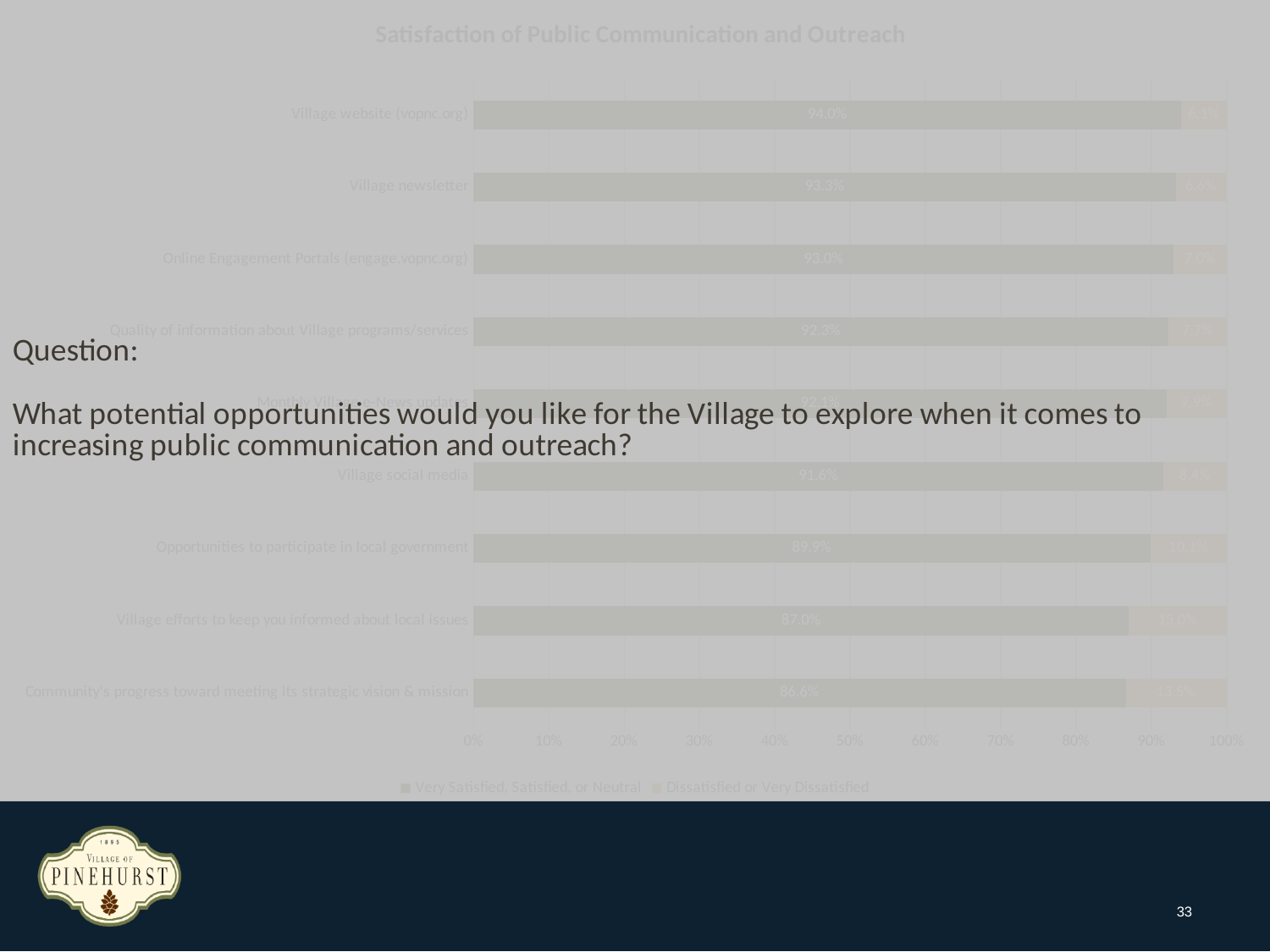
What is the difference between the Very Satisfied, Satisfied, or Neutral values for Village website (vopnc.org) and Village efforts to keep you informed about local issues? 7.0% What is the title of the chart? Satisfaction of Public Communication and Outreach How many series does the legend list? 2 Which category has the highest Very Satisfied, Satisfied, or Neutral value? Village website (vopnc.org) What kind of chart is shown on the slide? Bar chart What is the Very Satisfied, Satisfied, or Neutral value for Village newsletter? 93.3% What is the Very Satisfied, Satisfied, or Neutral value for Online Engagement Portals (engage.vopnc.org)? 93.0% Which category has the lowest Very Satisfied, Satisfied, or Neutral value? Community's progress toward meeting its strategic vision & mission What is the Very Satisfied, Satisfied, or Neutral value for Village website (vopnc.org)? 94.0% Which has a larger Very Satisfied, Satisfied, or Neutral value: Village social media or Opportunities to participate in local government? Village social media Is the Very Satisfied, Satisfied, or Neutral value for Opportunities to participate in local government greater or less than 80%? greater What is the Very Satisfied, Satisfied, or Neutral value for Community's progress toward meeting its strategic vision & mission? 86.6%